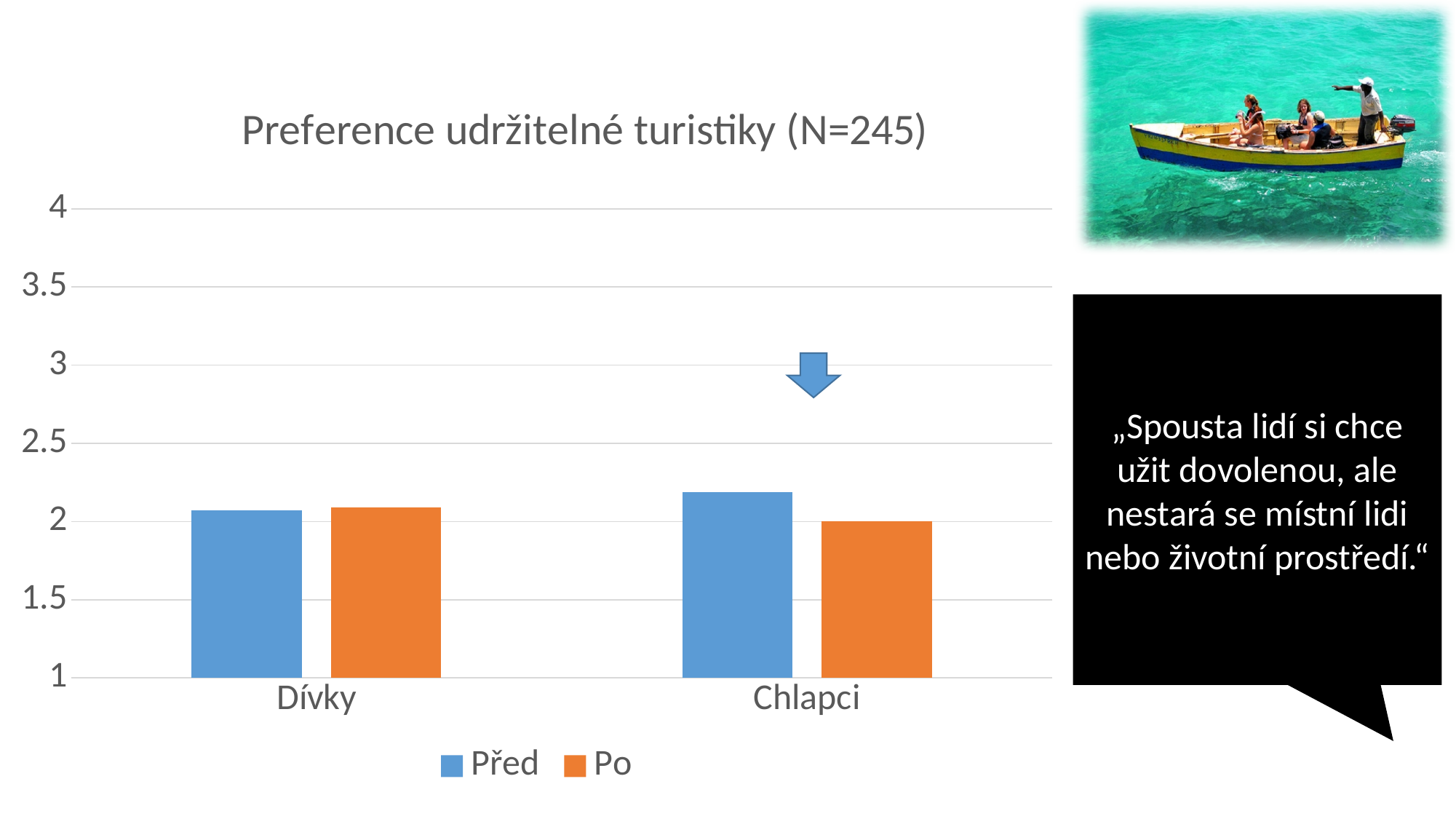
What is the title of the chart? Preference udržitelné turistiky (N=245) Which bar is the highest in the chart? Chlapci, Před How many categories are shown on the x axis? 2 What kind of chart is shown on the slide? bar chart Is the value for Chlapci in the Před series greater or less than 2.5? less Which series is shown in orange? Po Is the value for Chlapci in the Po series greater or less than 3? less Does the Po series rise or fall from Dívky to Chlapci? fall For Chlapci, which series has the larger value, Před or Po? Před Is the value for Chlapci in the Před series greater or less than 2? greater How many series does the legend list? 2